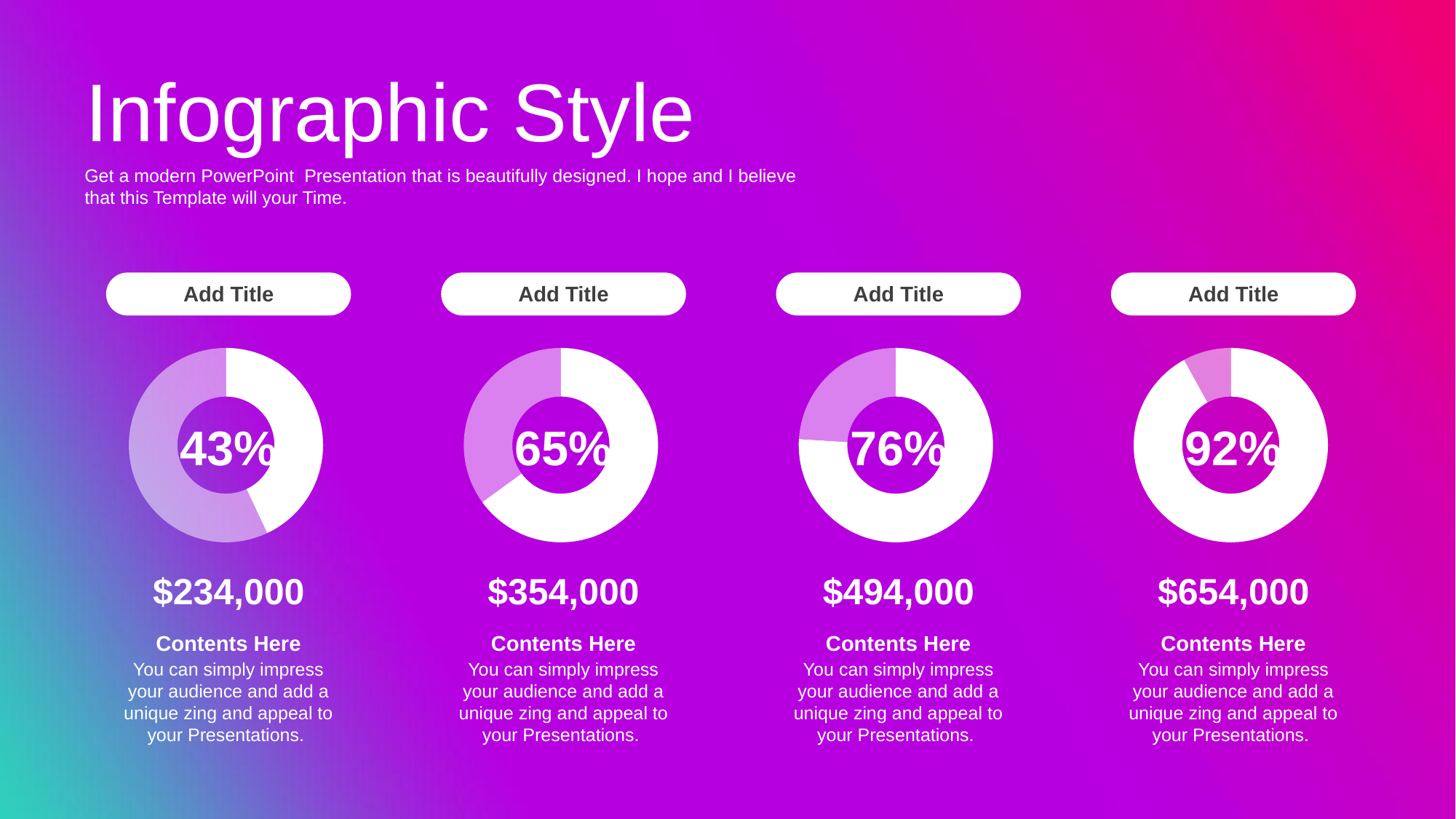
Which is larger: the percentage in the second donut chart or the percentage in the third donut chart? The third donut chart (76%) How many donut charts are on the slide? 4 What dollar value is printed below the leftmost donut chart? $234,000 What kind of chart is used for each of the four figures on the slide? Donut chart Which donut chart shows the lowest percentage? The leftmost chart (43%) What percentage is shown in the centre of the leftmost donut chart? 43% Which donut chart shows the highest percentage? The rightmost chart (92%) What percentage is shown in the centre of the third donut chart from the left? 76% What dollar value is printed below the rightmost donut chart? $654,000 What percentage is shown in the centre of the rightmost donut chart? 92% What percentage is shown in the centre of the second donut chart from the left? 65% What is the difference between the percentage in the rightmost donut chart and the percentage in the leftmost donut chart? 49%